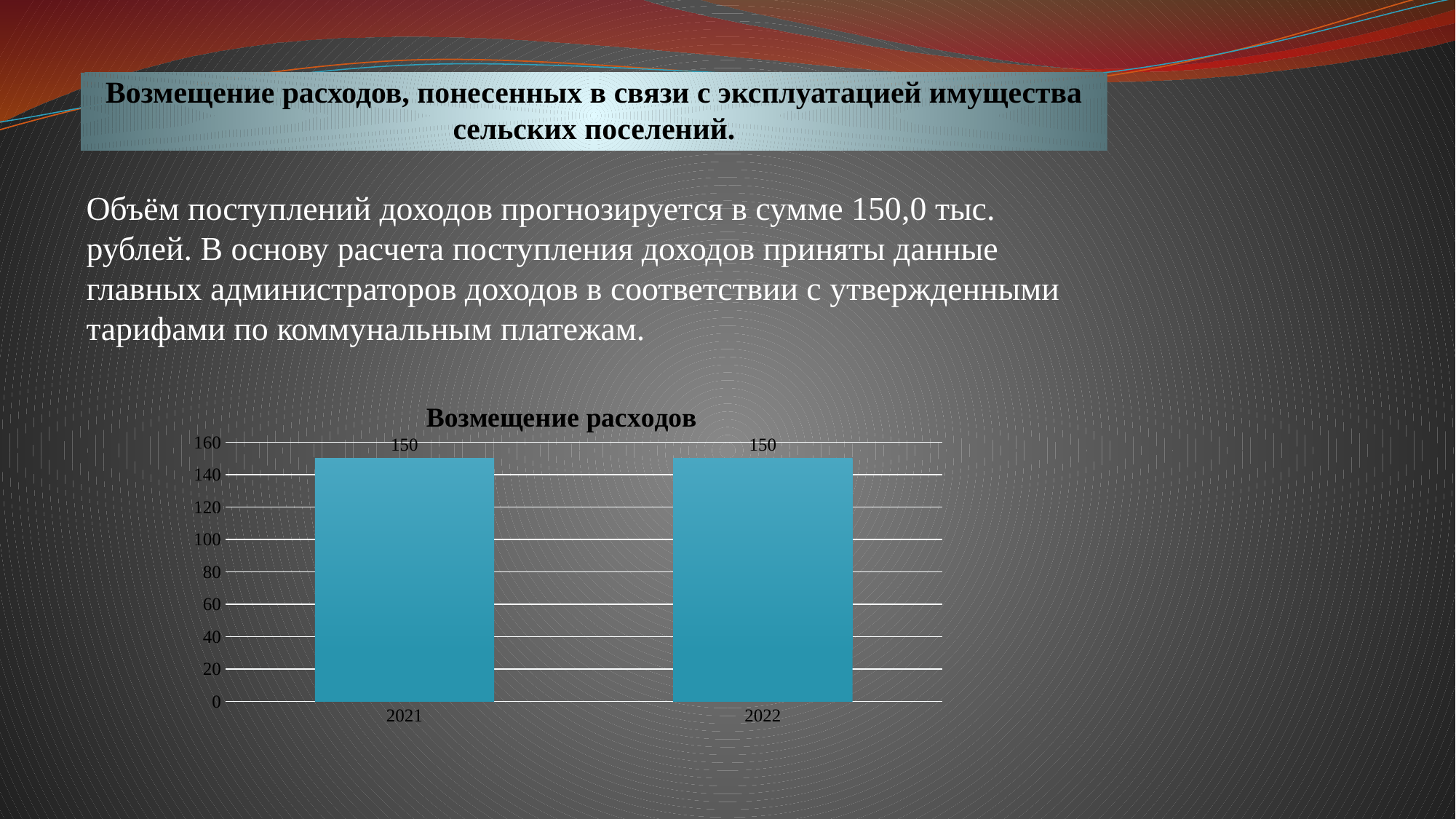
How many categories are shown on the x axis of the chart? 2 What kind of chart is shown on the slide? bar chart What is the title of the chart? Возмещение расходов Is the value for 2022 greater or less than 160? less What is the value for 2021 in the chart? 150 What is the value for 2022 in the chart? 150 What is the highest value shown on the vertical axis of the chart? 160 Do the values rise, fall or stay the same from 2021 to 2022? stay the same Is the value for 2021 greater or less than 140? greater What is the difference between the values for 2021 and 2022? 0